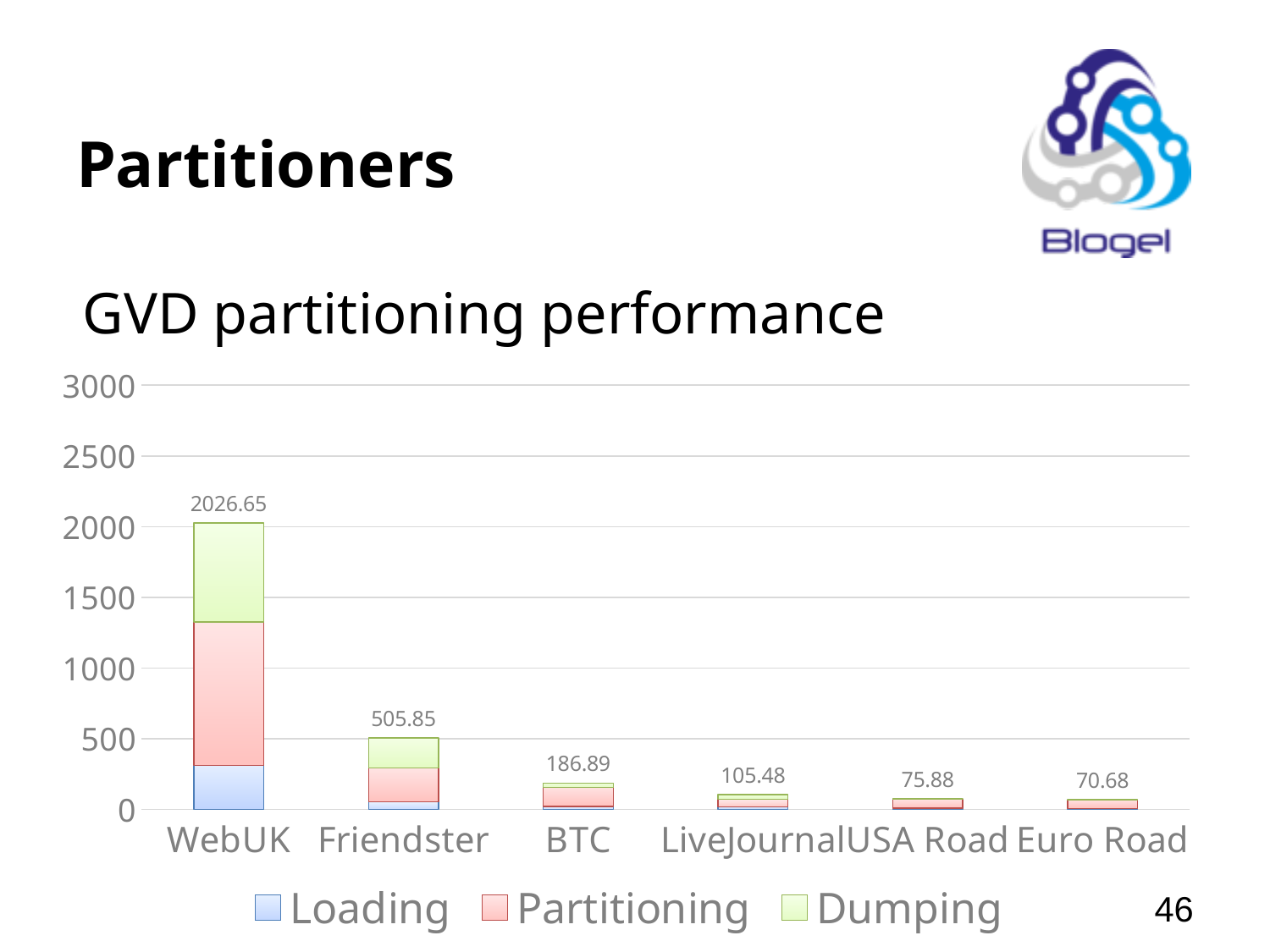
How many series does the legend list? 3 What is the difference between the total for USA Road and the total for Euro Road? 5.20 Which dataset has the highest total bar? WebUK What is the total value labelled for the Euro Road bar? 70.68 Which has a larger total, BTC or LiveJournal? BTC How many datasets are shown on the x axis? 6 What is the total value labelled for the Friendster bar? 505.85 What is the total value labelled for the WebUK bar? 2026.65 What is the difference between the total for WebUK and the total for Friendster? 1520.80 Which dataset has the lowest total bar? Euro Road What kind of chart is shown on the slide? Stacked bar chart Is the Loading segment for WebUK greater or less than 500? less